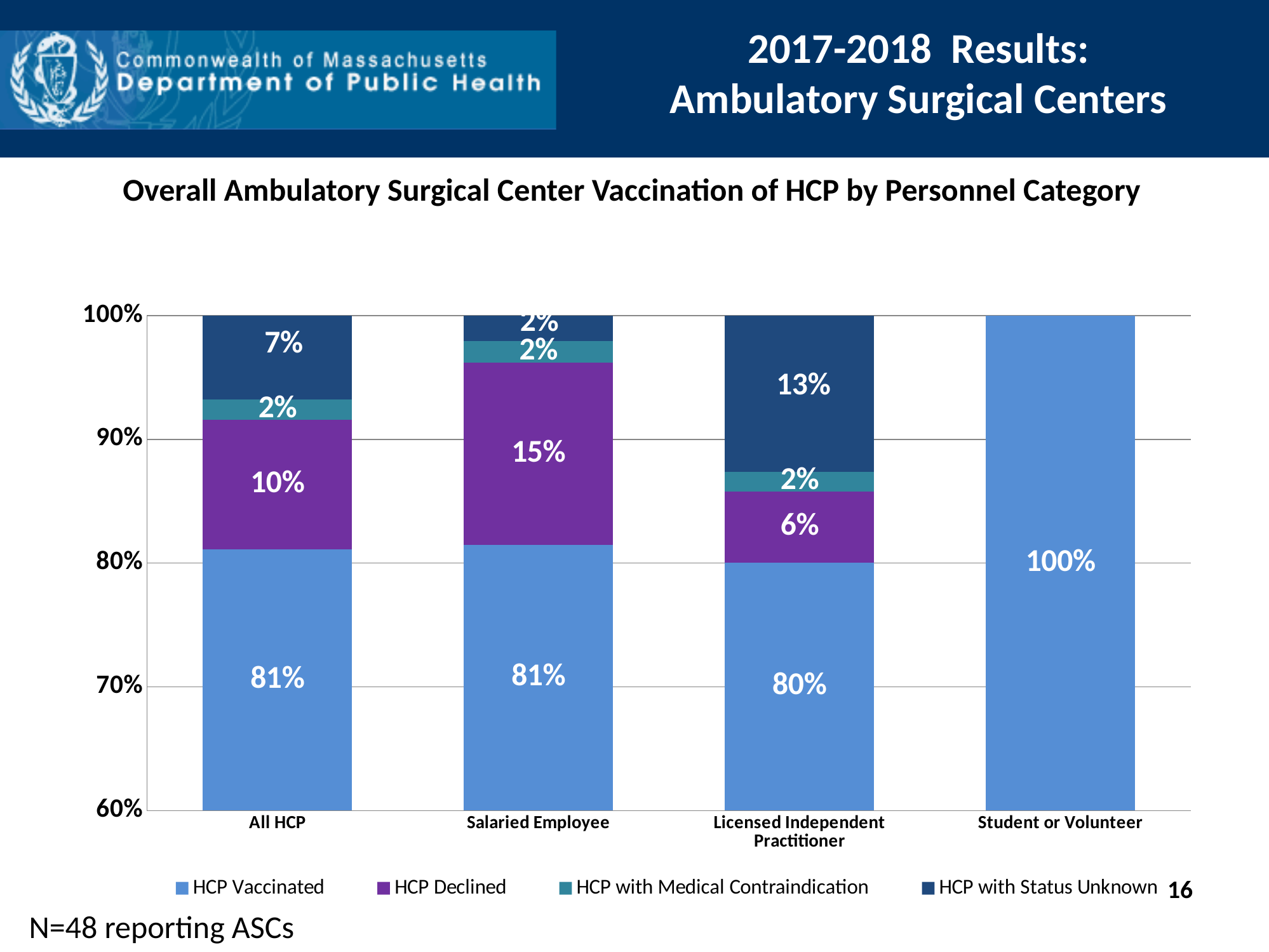
What kind of chart is shown on the slide? Stacked bar chart What is the difference between the HCP Declined values for Salaried Employee and All HCP? 5% Which personnel category has the highest HCP Vaccinated percentage? Student or Volunteer How many personnel categories are shown on the x axis? 4 Which personnel category has the lowest HCP Declined percentage among those with a declined segment? Licensed Independent Practitioner Is the HCP Declined value larger for Salaried Employee or for Licensed Independent Practitioner? Salaried Employee What is the HCP Declined value for Salaried Employee? 15% How many series does the legend list? 4 What is the HCP Vaccinated value for Student or Volunteer? 100% What percentage of HCP were vaccinated in the All HCP category? 81% What is the HCP with Status Unknown value for Licensed Independent Practitioner? 13% What is the title of the chart? Overall Ambulatory Surgical Center Vaccination of HCP by Personnel Category